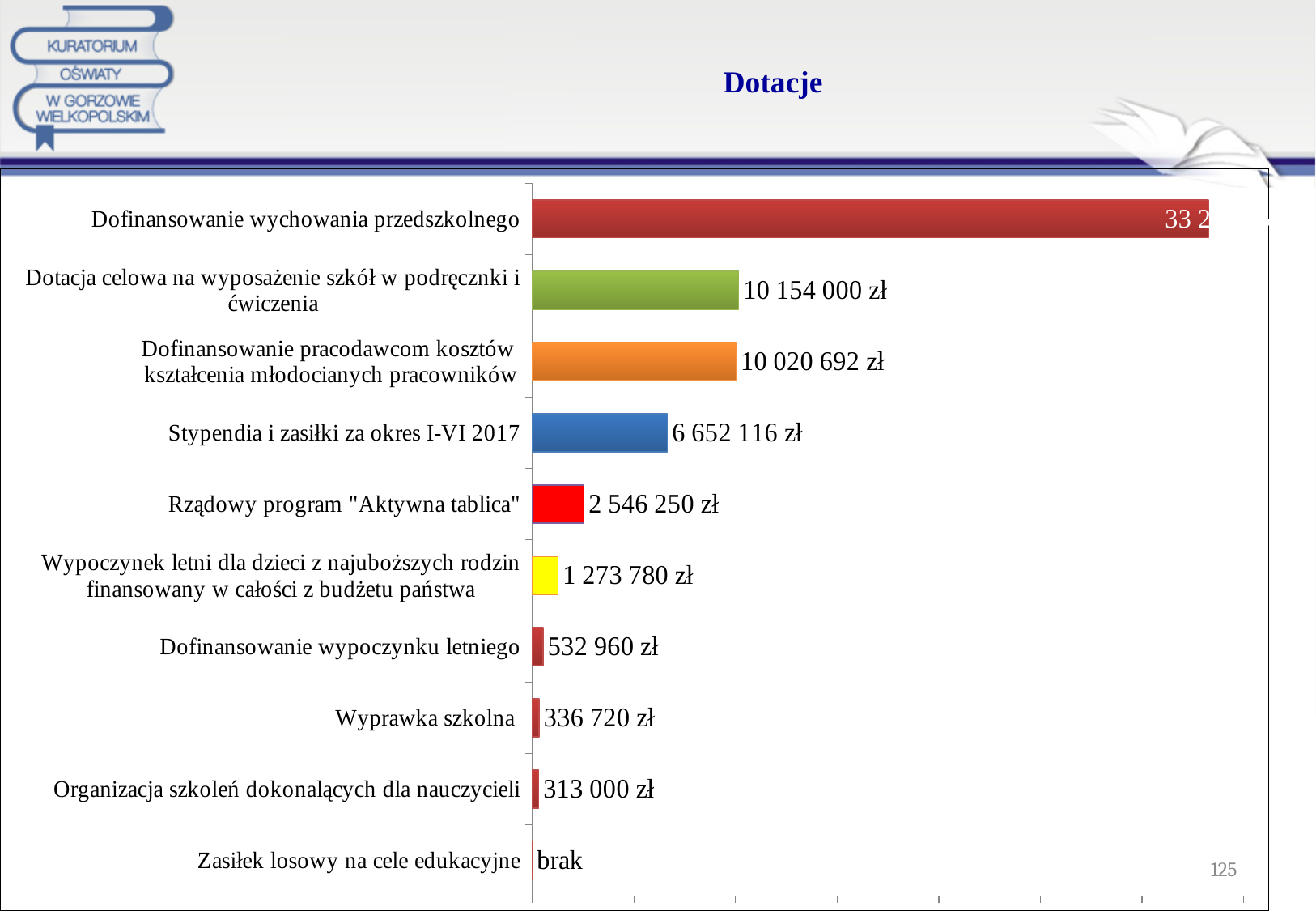
Which is larger: "Rządowy program "Aktywna tablica"" or "Wypoczynek letni dla dzieci z najuboższych rodzin finansowany w całości z budżetu państwa"? Rządowy program "Aktywna tablica" What is the value for "Rządowy program "Aktywna tablica""? 2 546 250 zł What is the value for "Dotacja celowa na wyposażenie szkół w podręczniki i ćwiczenia"? 10 154 000 zł How many categories are shown on the chart? 10 What is the value for "Wyprawka szkolna"? 336 720 zł What is shown for "Zasiłek losowy na cele edukacyjne"? brak What kind of chart is shown on the slide? Bar chart What is the difference between "Dotacja celowa na wyposażenie szkół w podręczniki i ćwiczenia" and "Dofinansowanie pracodawcom kosztów kształcenia młodocianych pracowników"? 133 308 zł What is the value for "Stypendia i zasiłki za okres I-VI 2017"? 6 652 116 zł Which category has the longest bar? Dofinansowanie wychowania przedszkolnego Which category with a printed amount has the lowest value? Organizacja szkoleń dokonalących dla nauczycieli What is the difference between "Dofinansowanie wypoczynku letniego" and "Wyprawka szkolna"? 196 240 zł